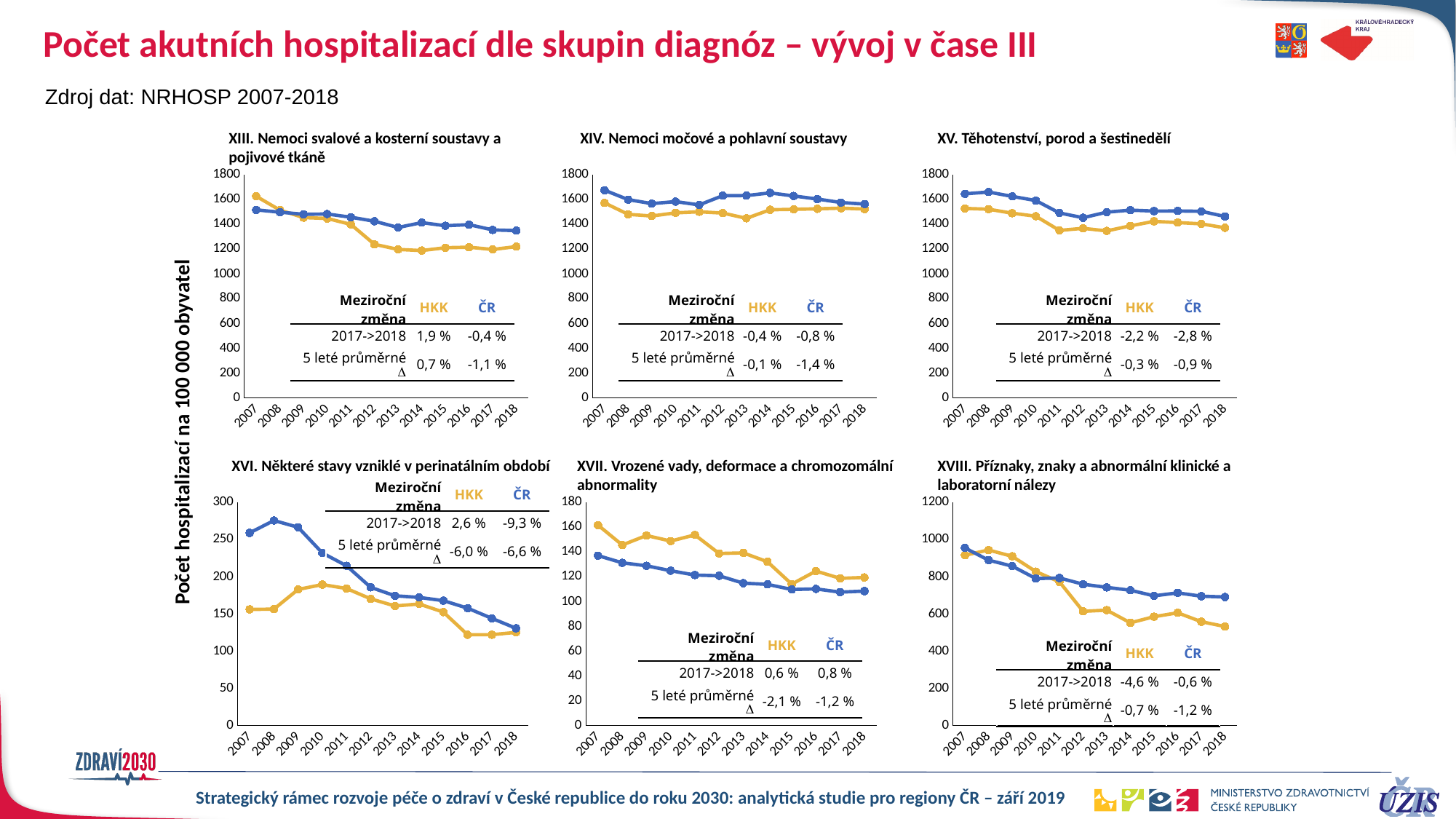
In chart XIV (Nemoci močové a pohlavní soustavy), what is the 5-year average change (5 leté průměrné Δ) for ČR? -1,4 % In chart XIII (Nemoci svalové a kosterní soustavy a pojivové tkáně), is the HKK value for 2018 greater or less than 1400? less How many years are plotted on the x axis of chart XIV (Nemoci močové a pohlavní soustavy)? 12 In chart XVI (Některé stavy vzniklé v perinatálním období), what is the 2017->2018 change for ČR? -9,3 % In chart XVIII (Příznaky, znaky a abnormální klinické a laboratorní nálezy), does the ČR line rise or fall from 2007 to 2018? fall In chart XVII (Vrozené vady, deformace a chromozomální abnormality), which has the larger 2017->2018 change, HKK or ČR? ČR How many series are shown in chart XV (Těhotenství, porod a šestinedělí)? 2 What kind of chart is chart XVII (Vrozené vady, deformace a chromozomální abnormality)? line chart In chart XVIII (Příznaky, znaky a abnormální klinické a laboratorní nálezy), what is the 2017->2018 change for HKK? -4,6 % In chart XV (Těhotenství, porod a šestinedělí), what is the 2017->2018 change for ČR? -2,8 % In chart XIII (Nemoci svalové a kosterní soustavy a pojivové tkáně), what is the 2017->2018 change for HKK? 1,9 % In chart XVI (Některé stavy vzniklé v perinatálním období), is the ČR value for 2008 greater or less than 250? greater